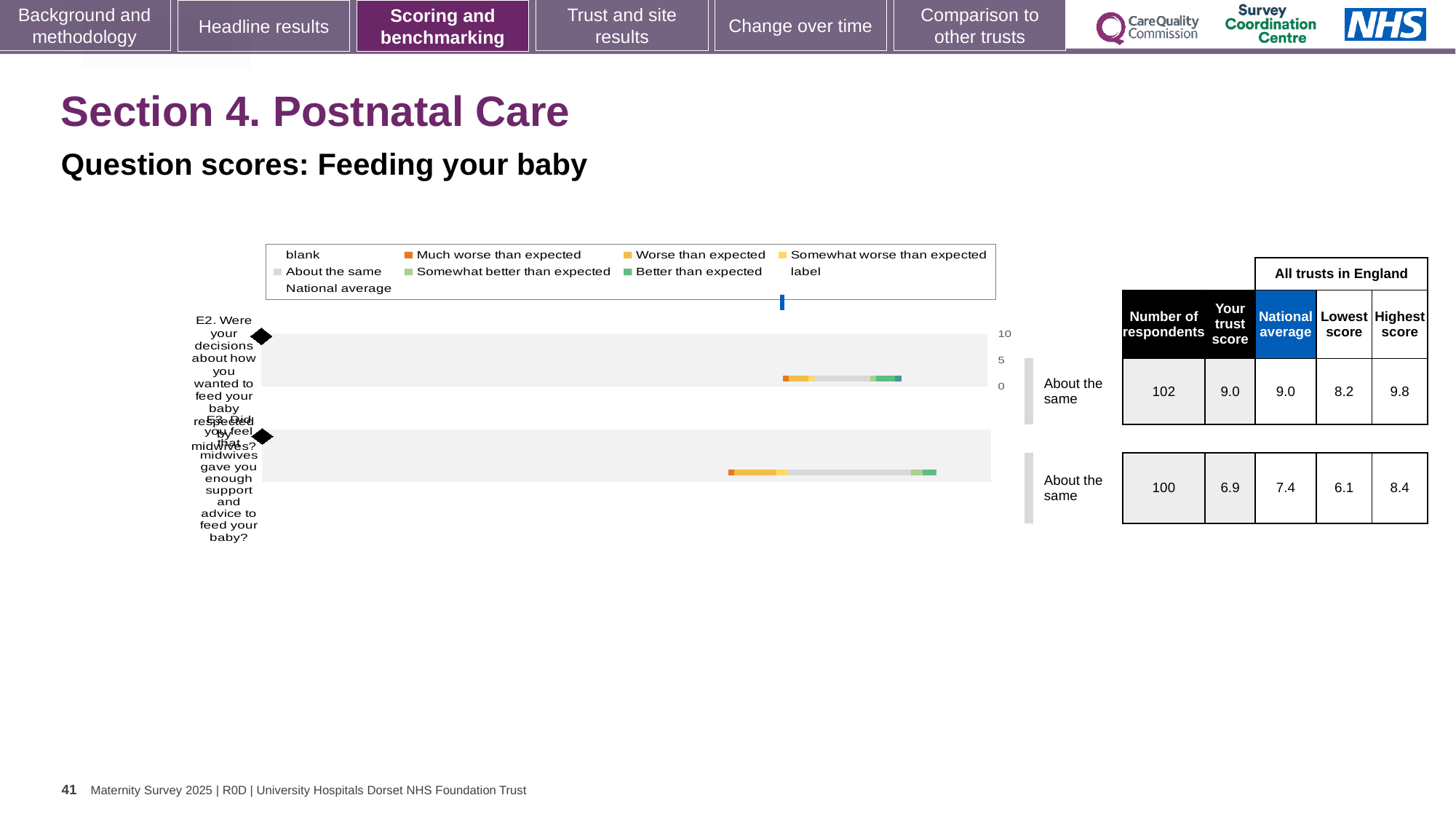
What is the trust score for question E3 about midwives giving enough support and advice to feed your baby? 6.9 What benchmark category is given for both E2 and E3? About the same What is the lowest score among all trusts in England for question E3? 6.1 What kind of chart is shown on the slide? bar chart What is the difference between the trust scores for E2 and E3? 2.1 Which question has the higher trust score, E2 or E3? E2 What is the highest score among all trusts in England for question E2? 9.8 How many questions (categories) are plotted in the chart? 2 How many respondents answered question E2? 102 What colour does the legend use for 'Much worse than expected'? orange What is the trust score for question E2 about decisions on how to feed your baby being respected by midwives? 9.0 What is the national average for question E3? 7.4